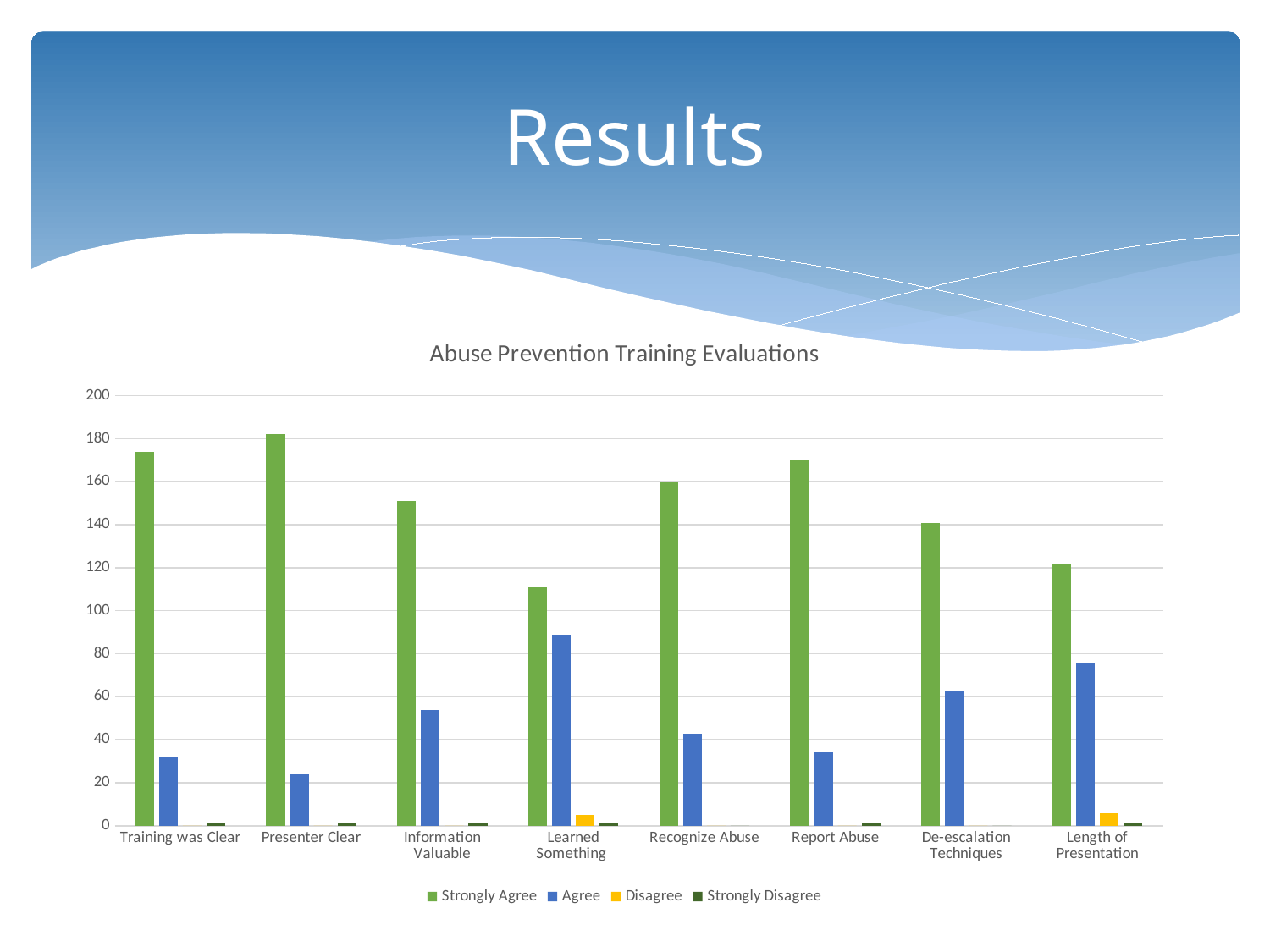
What is the title of the chart? Abuse Prevention Training Evaluations Which category has the highest Agree value? Learned Something How many categories are shown on the x axis? 8 Which category has the lowest Agree value? Presenter Clear Which is larger, the Agree value for De-escalation Techniques or the Agree value for Report Abuse? De-escalation Techniques What type of chart is shown on the slide? bar chart Is the Strongly Agree value for Information Valuable greater or less than 140? greater Which category has the highest Strongly Agree value? Presenter Clear Which category has the lowest Strongly Agree value? Learned Something Is the Strongly Agree value for Length of Presentation greater or less than 140? less How many series does the legend list? 4 Is the Agree value for Learned Something greater or less than 80? greater